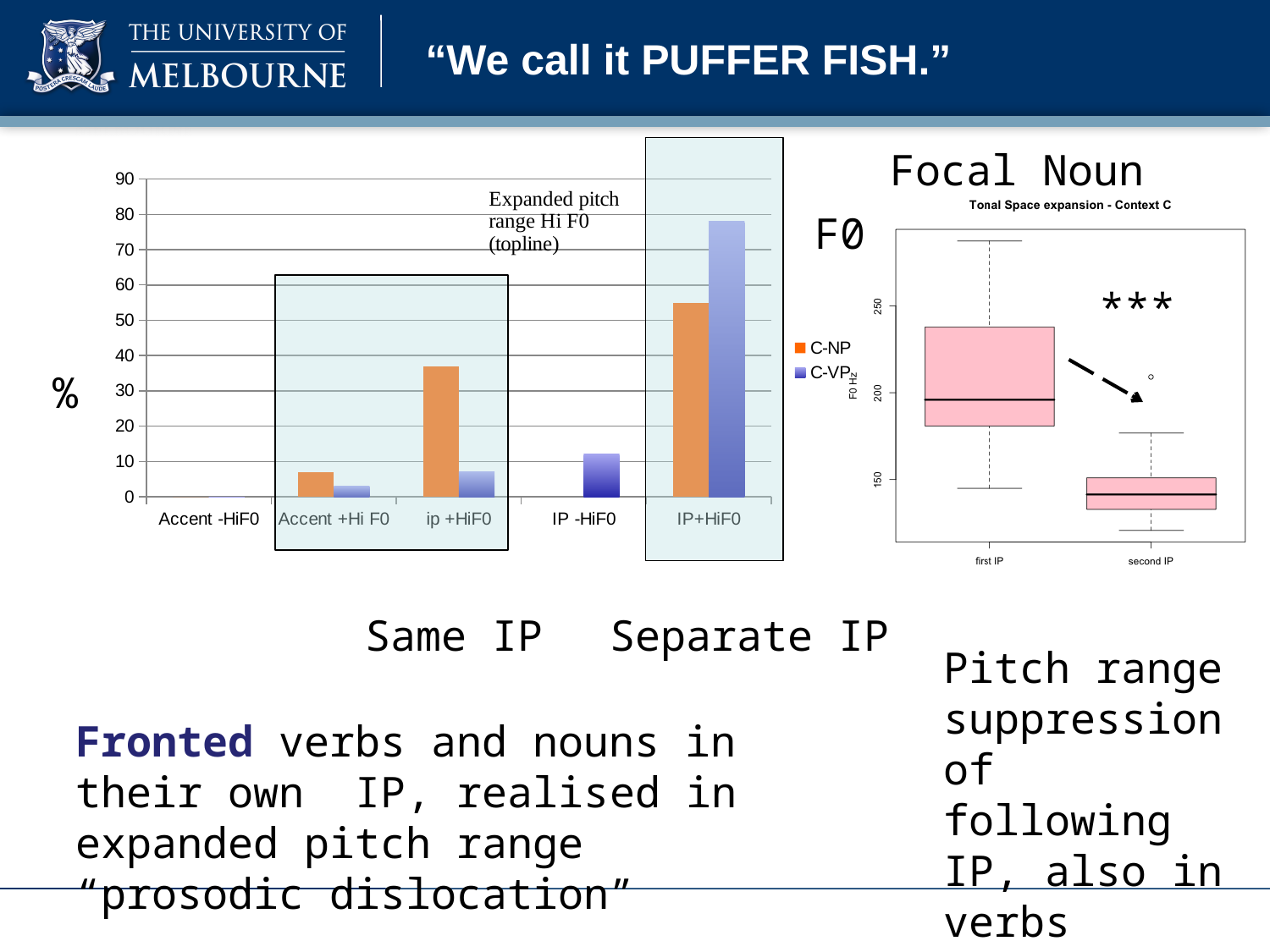
What kind of chart is the left chart with the C-NP and C-VP series? bar chart In the left bar chart, is the C-VP value for IP+HiF0 greater or less than 70? greater In the left bar chart, is the C-NP value for ip +HiF0 greater or less than 30? greater What is the title of the box plot on the right of the slide? Tonal Space expansion - Context C In the left bar chart, for the IP+HiF0 category, which series has the larger value, C-NP or C-VP? C-VP In the left bar chart, is the C-VP value for IP -HiF0 greater or less than 20? less In the box plot on the right, which group has the higher median F0, first IP or second IP? first IP How many series does the legend of the left bar chart list? 2 In the left bar chart, for the ip +HiF0 category, which series has the larger value, C-NP or C-VP? C-NP How many categories are shown on the x axis of the left bar chart? 5 In the left bar chart, which category has the highest C-NP value? IP+HiF0 In the left bar chart, which category has the highest C-VP value? IP+HiF0